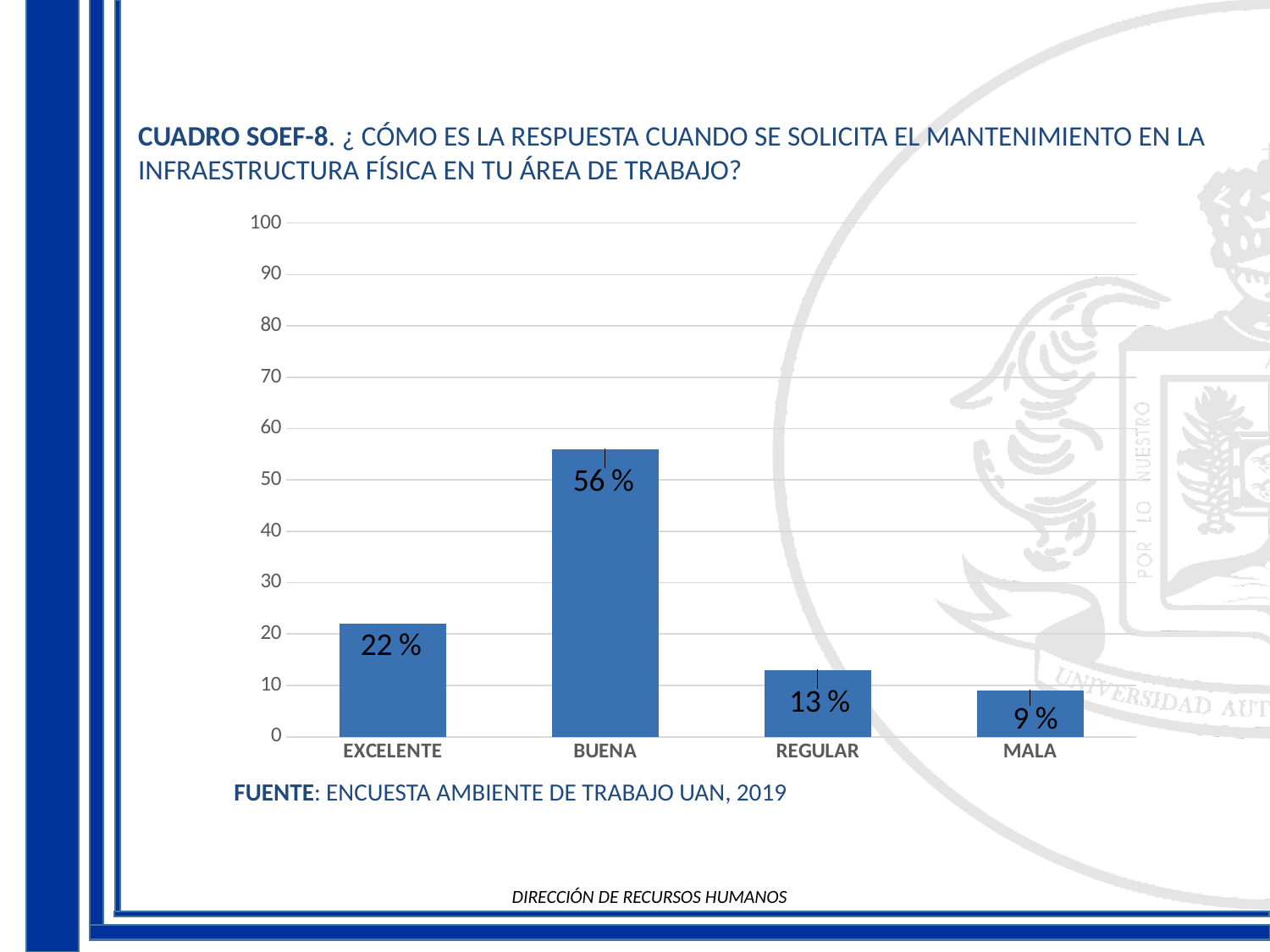
What is the value for MALA? 9 % What is the difference between the values for REGULAR and MALA? 4 % Which is larger, the value for EXCELENTE or the value for REGULAR? EXCELENTE Which category has the highest value? BUENA What is the value for REGULAR? 13 % Which category has the lowest value? MALA What is the difference between the values for BUENA and EXCELENTE? 34 % Is the value for BUENA greater or less than 50? greater What kind of chart is shown on the slide? bar chart How many categories are shown on the x axis? 4 What is the value for BUENA? 56 % What is the value for EXCELENTE? 22 %